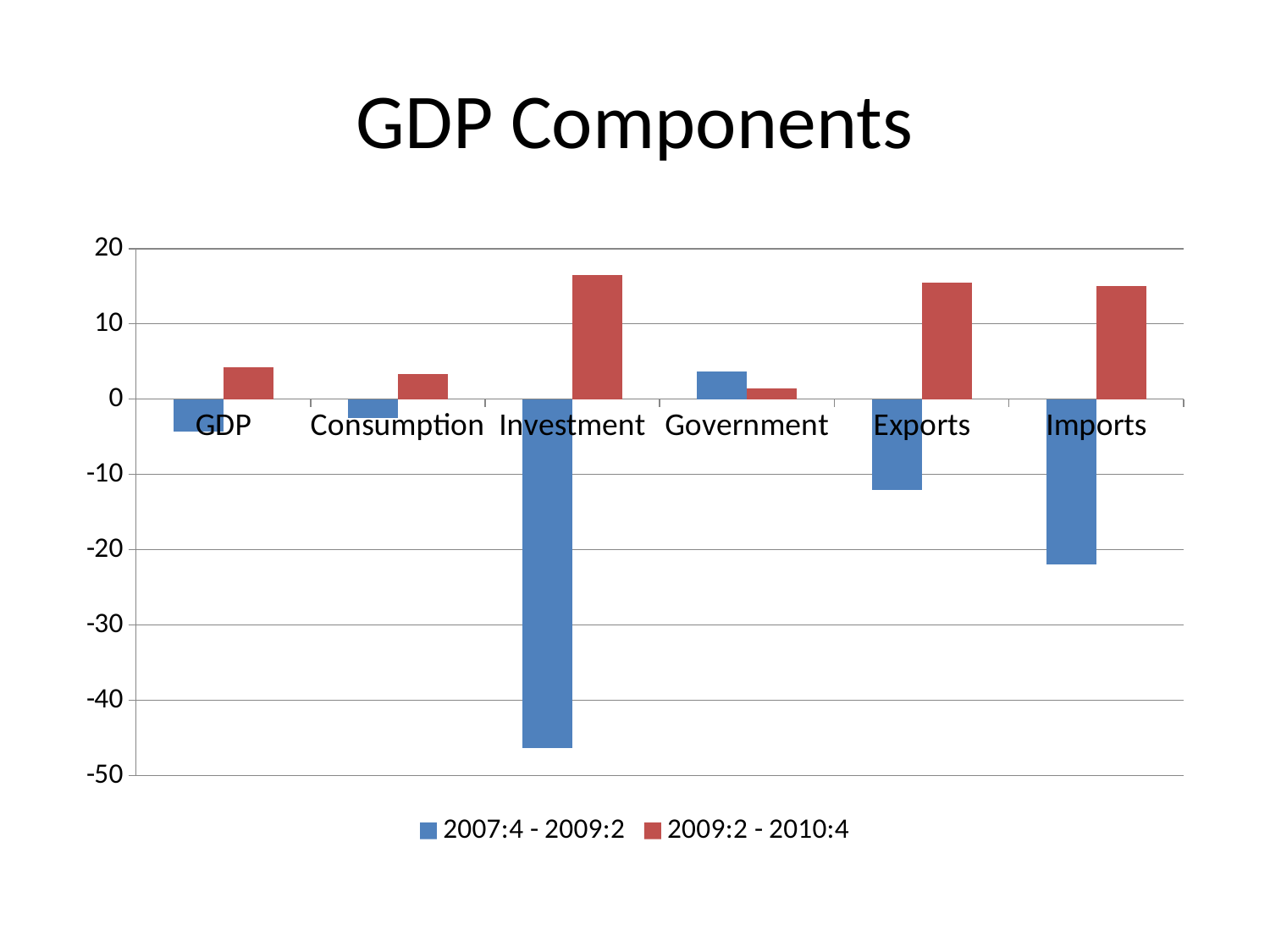
What is the title of the chart? GDP Components Which category has the highest value for the 2007:4 - 2009:2 series? Government How many series does the legend list? 2 Is the value for Exports in the 2007:4 - 2009:2 series greater or less than -10? less Which is larger for Imports: the 2007:4 - 2009:2 value or the 2009:2 - 2010:4 value? 2009:2 - 2010:4 Which category has the lowest value for the 2007:4 - 2009:2 series? Investment How many categories are shown on the x axis? 6 Which is larger for Government: the 2007:4 - 2009:2 value or the 2009:2 - 2010:4 value? 2007:4 - 2009:2 What kind of chart is shown on the slide? bar chart Is the value for Investment in the 2009:2 - 2010:4 series greater or less than 10? greater Which category has the lowest value for the 2009:2 - 2010:4 series? Government Is the value for Investment in the 2007:4 - 2009:2 series greater or less than -40? less